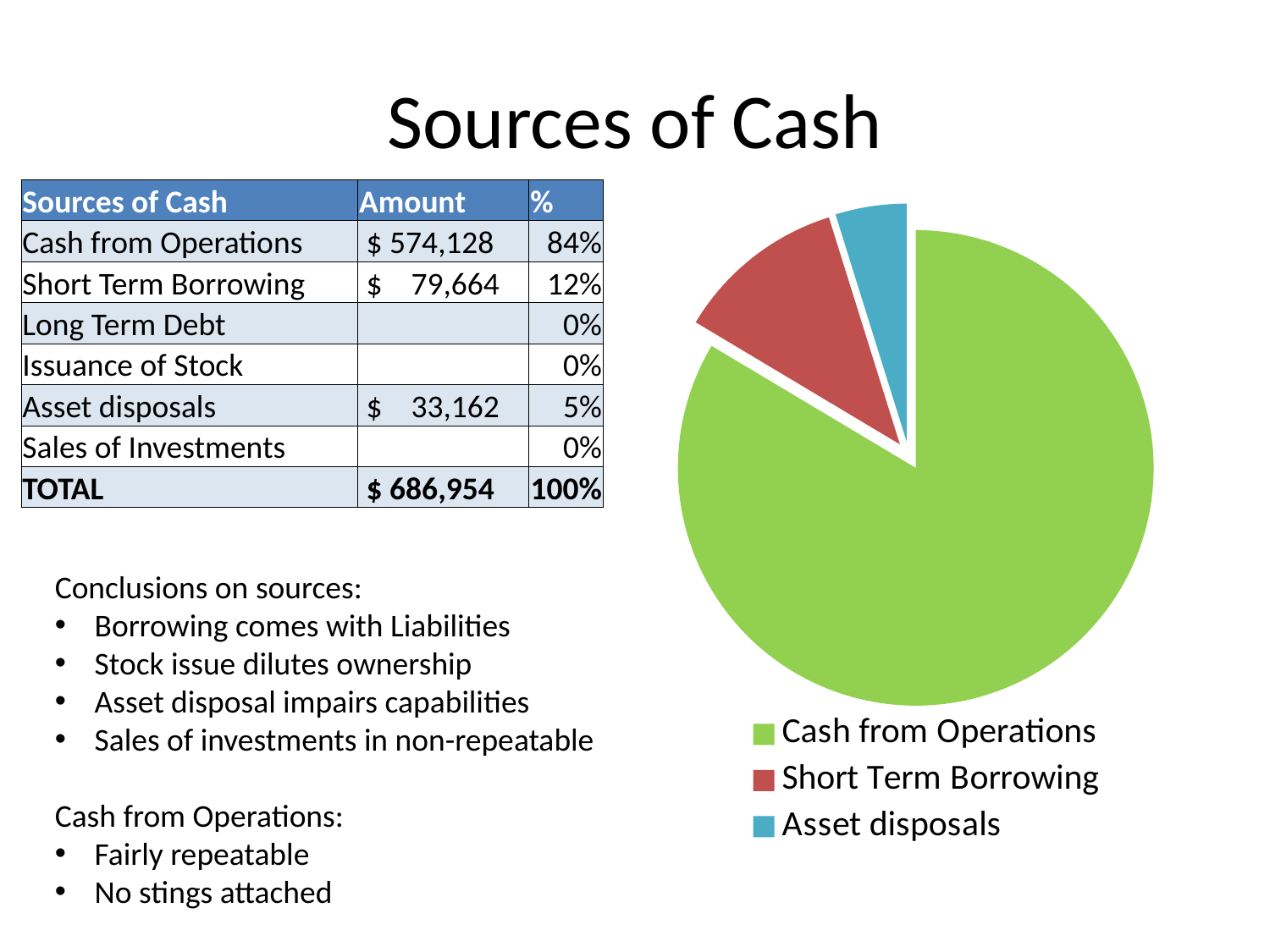
What kind of chart is shown on the slide? pie chart How many slices does the pie chart have? 3 What share of the pie does Cash from Operations represent, according to the slide? 84% What share of the pie does Asset disposals represent, according to the slide? 5% What amount does the slide give for the Cash from Operations slice? $ 574,128 What is the title of the slide containing the pie chart? Sources of Cash Which slice is larger in the pie chart, Short Term Borrowing or Asset disposals? Short Term Borrowing How many entries does the pie chart's legend list? 3 Which category has the smallest slice in the pie chart? Asset disposals What share of the pie does Short Term Borrowing represent, according to the slide? 12% What colour is the Cash from Operations slice in the pie chart? green Which category has the largest slice in the pie chart? Cash from Operations